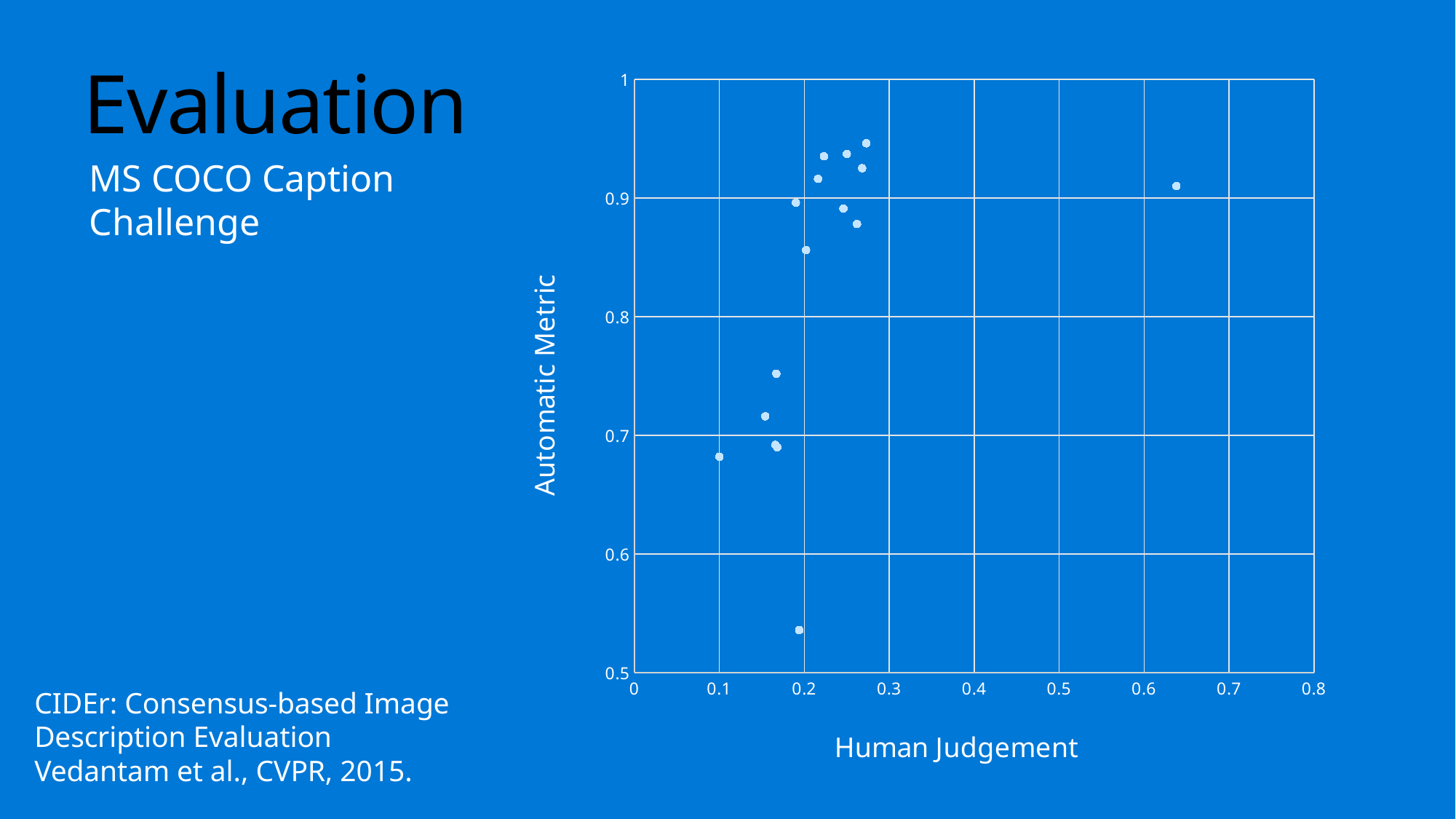
Is the Human Judgement value of the lowest point on the chart greater or less than 0.3? less What is the title of the vertical axis of the chart? Automatic Metric Is the Automatic Metric value of the rightmost point on the chart greater or less than 0.8? greater How many data points are plotted on the chart? 16 What is the title of the horizontal axis of the chart? Human Judgement What is the maximum value shown on the vertical axis of the chart? 1 Is the Human Judgement value of the rightmost point on the chart greater or less than 0.5? greater What kind of chart is shown on the slide? scatter plot